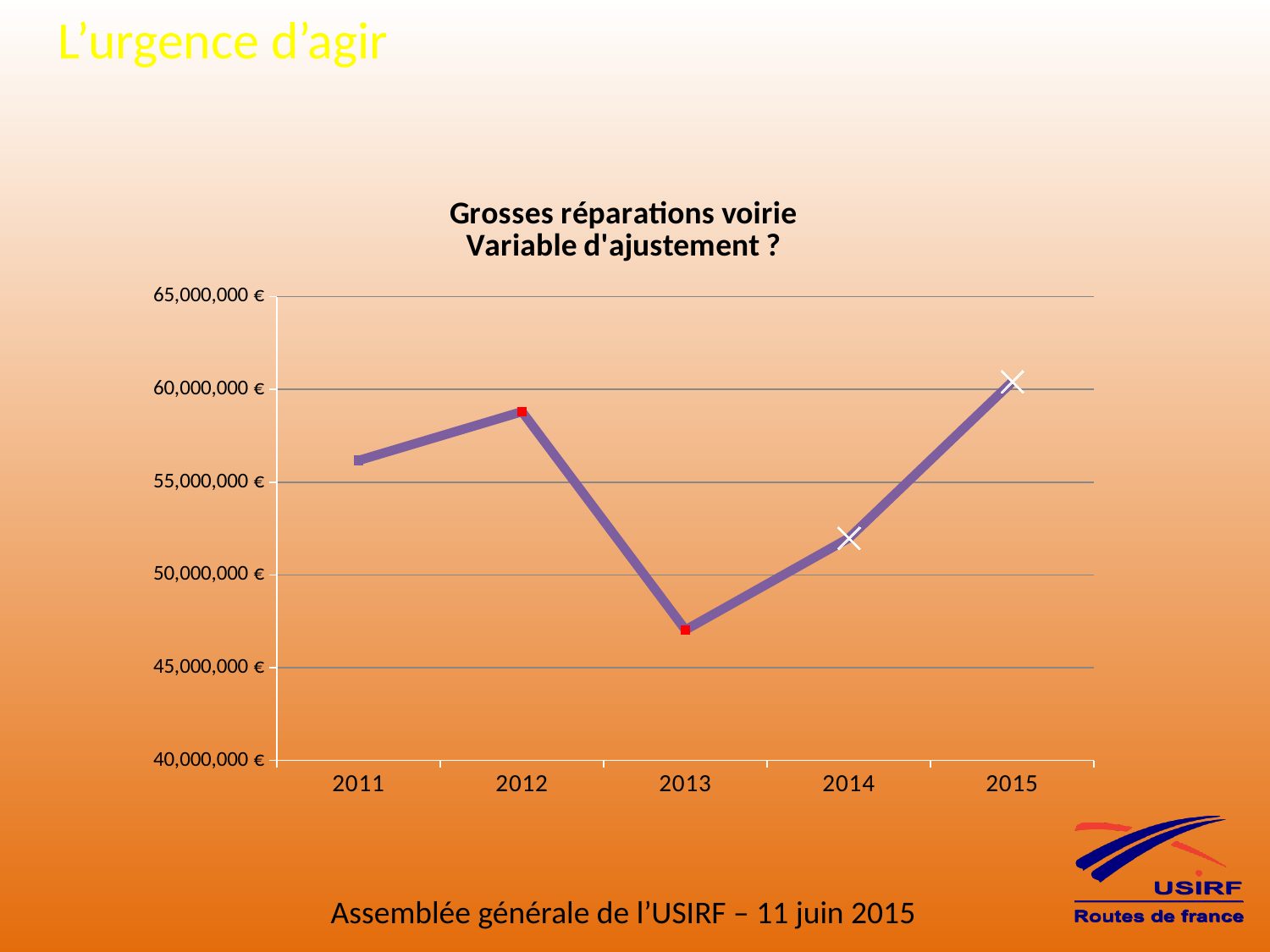
Is the value for 2013 greater or less than 50,000,000 €? less Is the value for 2014 greater or less than 55,000,000 €? less Which year has the highest value in the chart? 2015 Which year has the lowest value in the chart? 2013 Which year has the larger value, 2012 or 2014? 2012 How many years are plotted on the x axis of the chart? 5 What is the title of the chart? Grosses réparations voirie Variable d'ajustement ? Is the value for 2011 greater or less than 55,000,000 €? greater Does the value rise or fall from 2012 to 2013? fall Which year has the larger value, 2011 or 2013? 2011 What kind of chart is shown on the slide? line chart